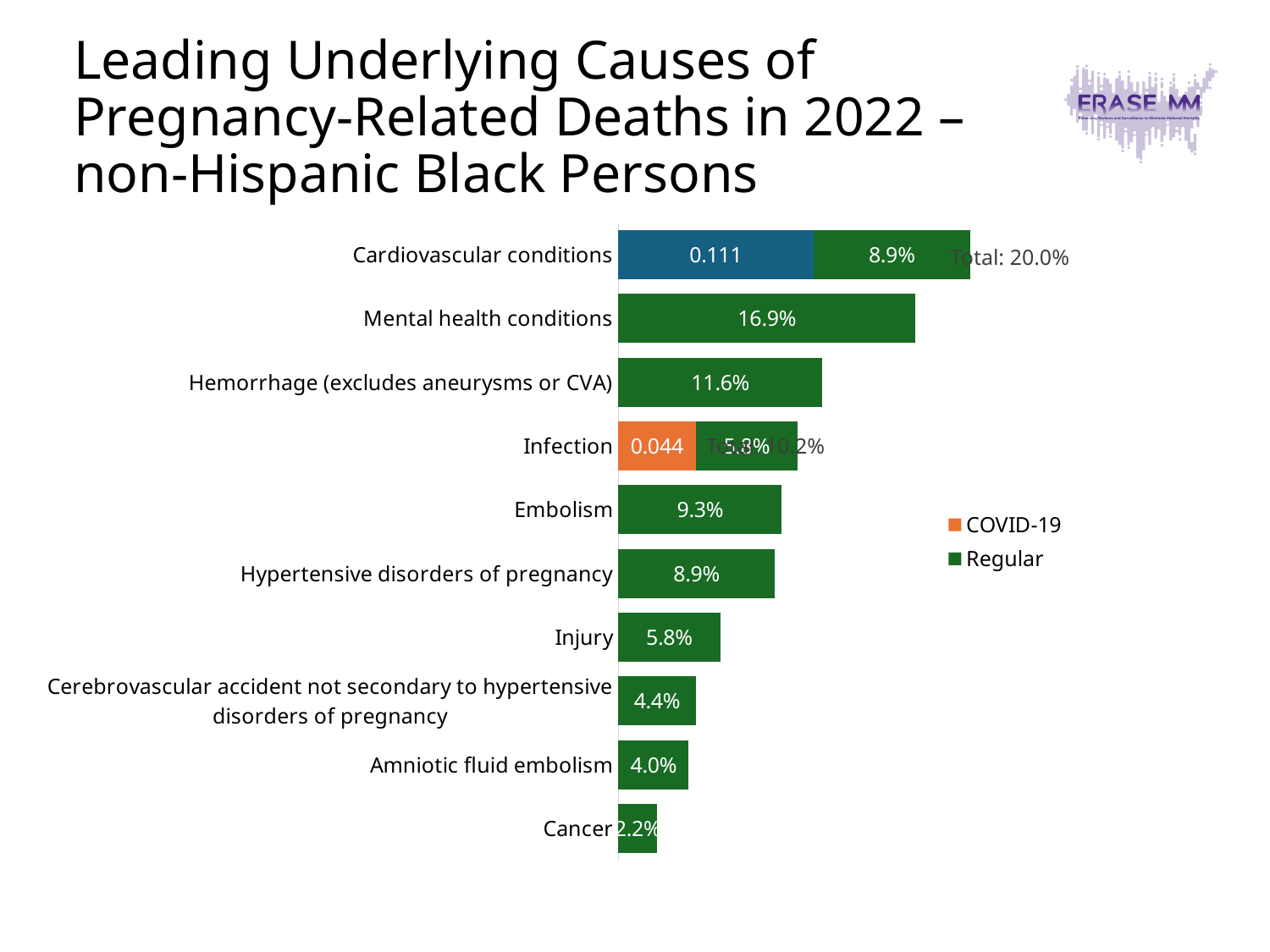
What is the Regular value for Cardiovascular conditions? 8.9% How many causes of death are listed on the chart? 10 What is the difference between Mental health conditions and Hemorrhage (excludes aneurysms or CVA)? 5.3% What is the value for Mental health conditions? 16.9% What is the value for Cancer? 2.2% Which cause has the lowest value? Cancer What kind of chart is shown on the slide? bar chart What is the value for Embolism? 9.3% How many series does the legend list? 2 What is the total shown for the Cardiovascular conditions bar? 20.0% What is the value for Hemorrhage (excludes aneurysms or CVA)? 11.6% Which is larger, Embolism or Hypertensive disorders of pregnancy? Embolism